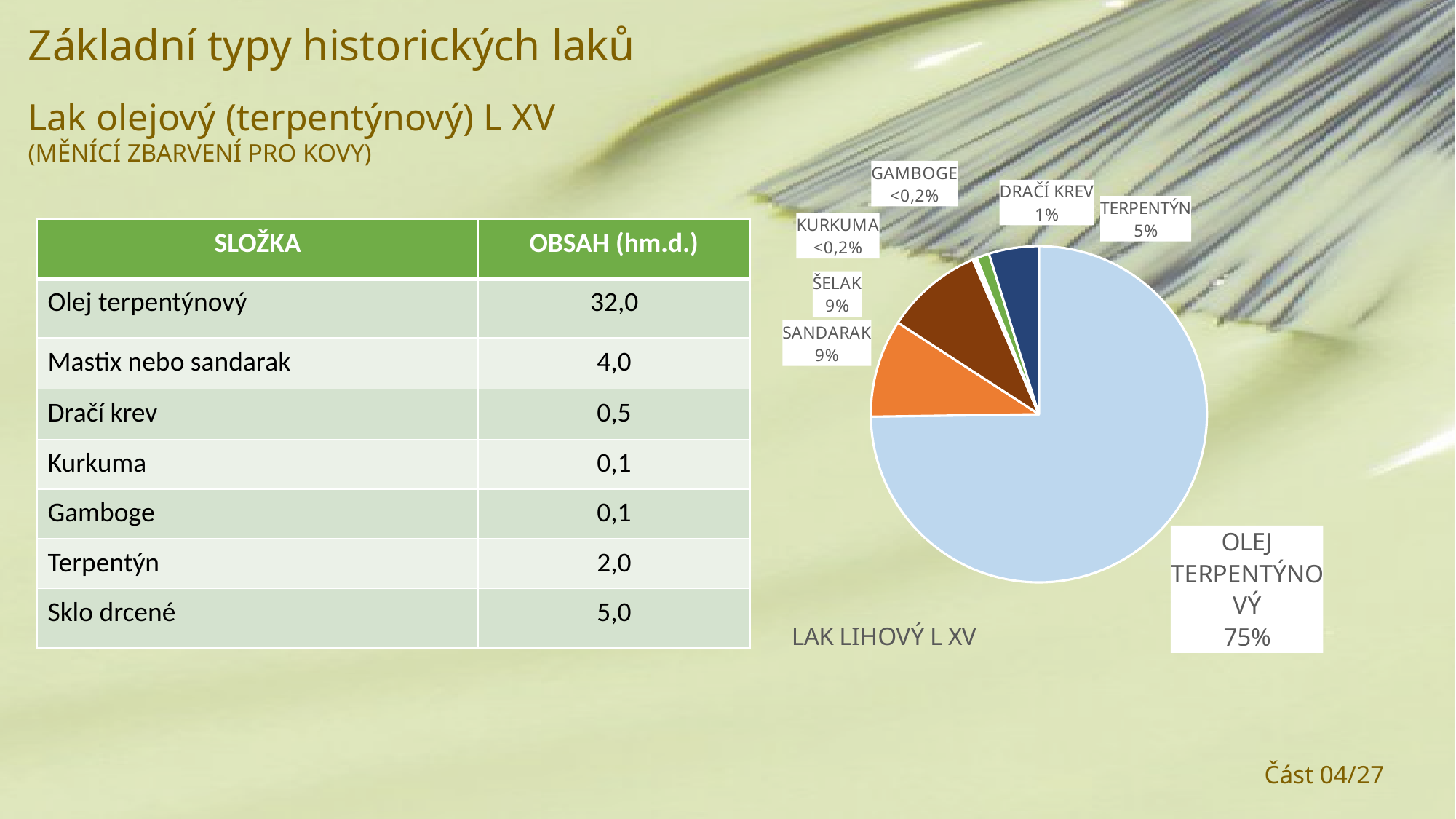
What is the title of the pie chart? LAK LIHOVÝ L XV What is the difference between the OLEJ TERPENTÝNOVÝ share and the TERPENTÝN share in the pie chart? 70% How many slices does the pie chart have? 7 What value is labelled for KURKUMA in the pie chart? <0,2% What is the value shown for TERPENTÝN in the pie chart? 5% What is the difference between the ŠELAK share and the DRAČÍ KREV share in the pie chart? 8% Which slice of the pie chart is the largest? OLEJ TERPENTÝNOVÝ What type of chart is shown on the slide? pie chart Which is larger in the pie chart, TERPENTÝN or DRAČÍ KREV? TERPENTÝN What is the value shown for DRAČÍ KREV in the pie chart? 1% What share of the pie chart does OLEJ TERPENTÝNOVÝ take? 75% What is the value shown for SANDARAK in the pie chart? 9%